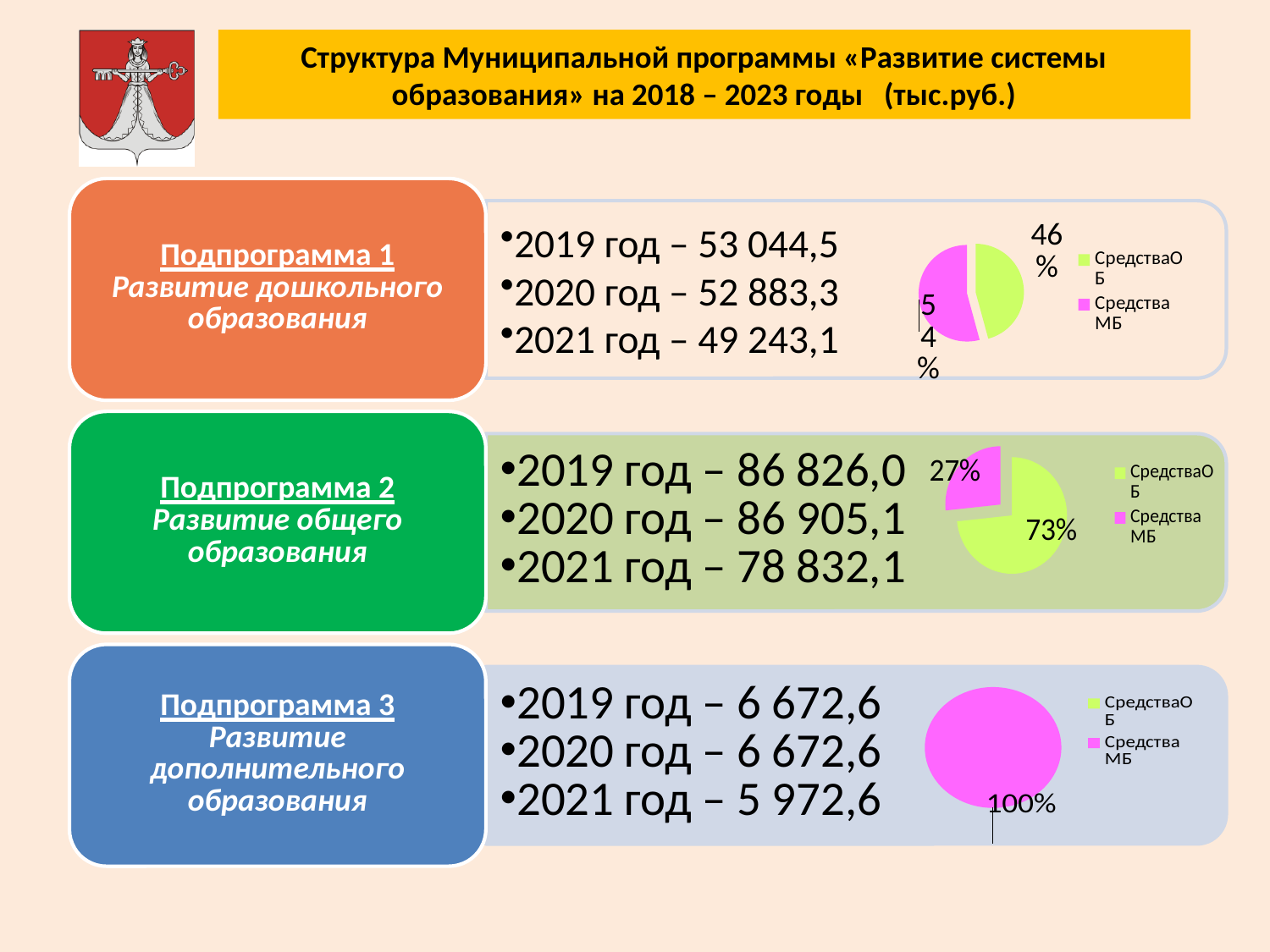
In the pie chart next to Подпрограмма 1, what share is labelled for Средства ОБ? 46% In the pie chart next to Подпрограмма 2, what is the difference in percentage points between the Средства ОБ and Средства МБ slices? 46 How many pie charts are shown on the slide? 3 In the pie chart next to Подпрограмма 2, what share is labelled for Средства МБ? 27% In the pie chart next to Подпрограмма 1, what share is labelled for Средства МБ? 54% In the pie chart next to Подпрограмма 1, which slice is larger, Средства ОБ or Средства МБ? Средства МБ In the pie chart next to Подпрограмма 1, which colour represents Средства МБ? Magenta (pink) In the pie chart next to Подпрограмма 2, which slice is larger, Средства ОБ or Средства МБ? Средства ОБ How many entries does the legend of the pie chart next to Подпрограмма 3 list? 2 What type of chart is shown next to Подпрограмма 2? Pie chart